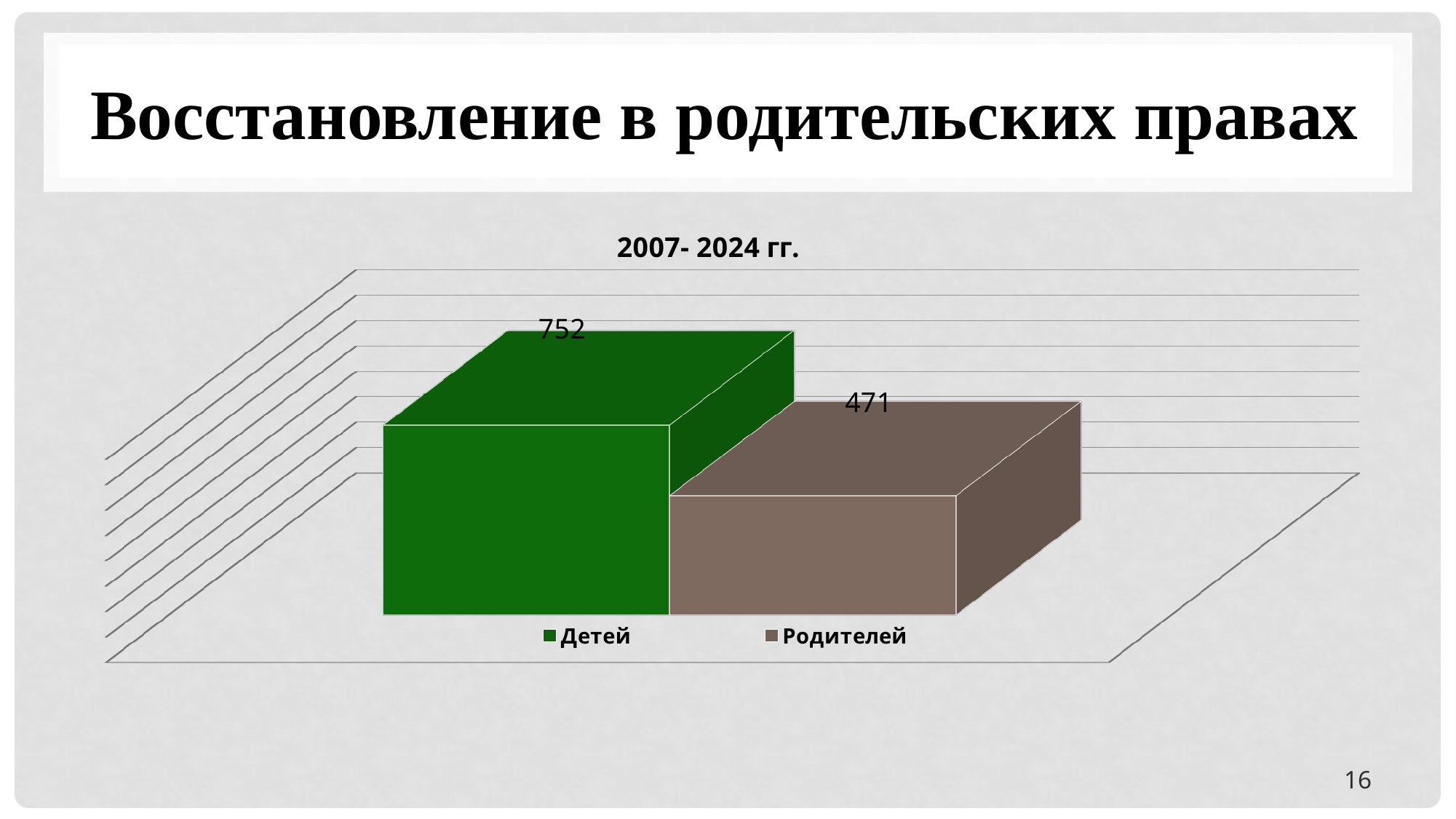
Which series has the highest value? Детей How many series does the legend list? 2 What colour is the bar for Детей? green What is the value for Детей? 752 What is the difference between the values for Детей and Родителей? 281 What kind of chart is shown on the slide? bar chart What is the title of the chart? 2007- 2024 гг. How many bars are plotted on the chart? 2 Which is larger, the value for Детей or the value for Родителей? Детей Which series has the lowest value? Родителей What is the value for Родителей? 471